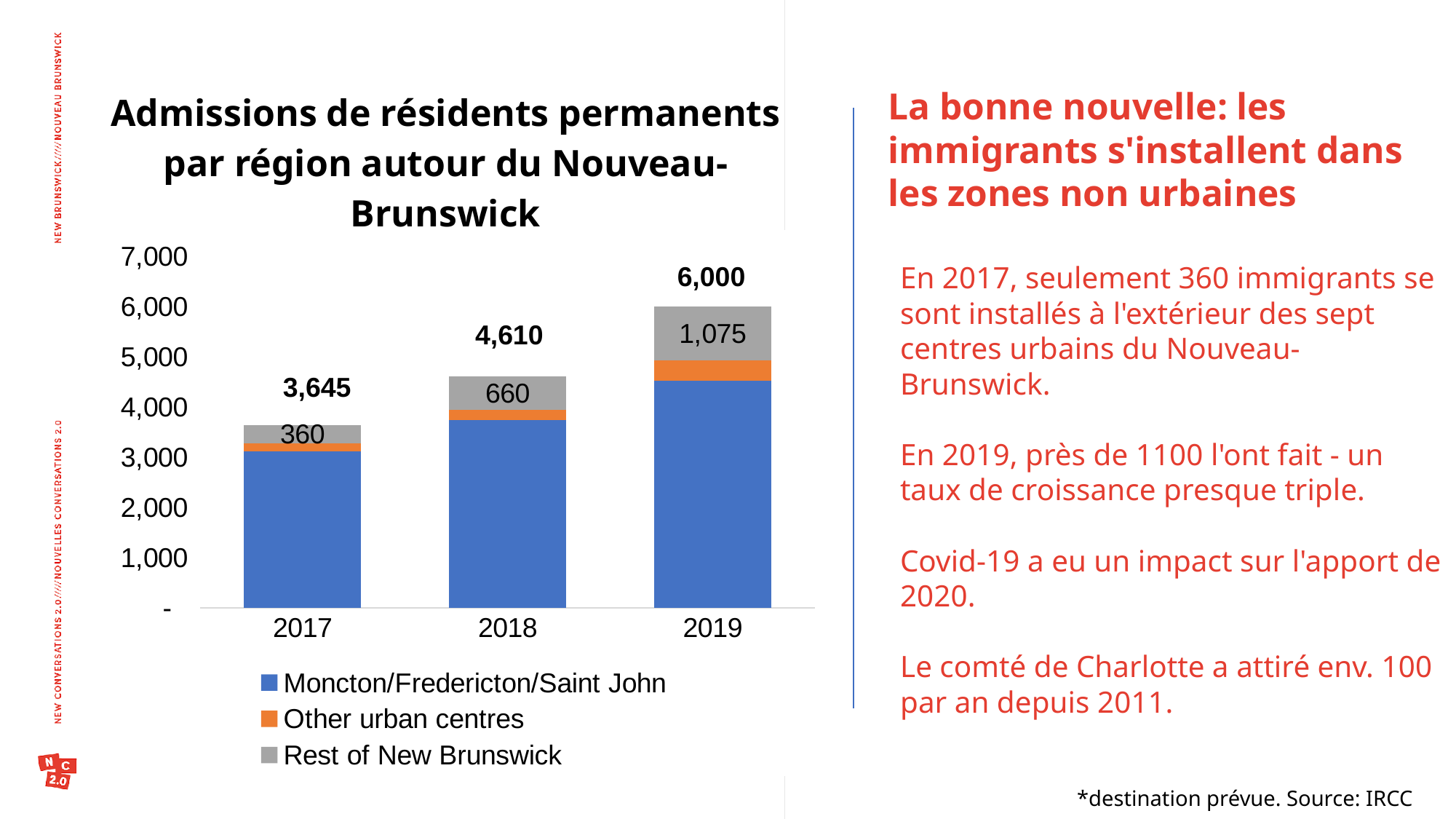
What is the difference between the Rest of New Brunswick values for 2019 and 2017? 715 Is the value for Moncton/Fredericton/Saint John in 2019 greater or less than 4,000? greater Which year has the lowest value for Rest of New Brunswick? 2017 What is the value for Rest of New Brunswick in 2018? 660 How many series does the legend list? 3 What is the total value of the stacked bar for 2019? 6,000 Which year has the highest total admissions? 2019 What kind of chart is shown on the slide? Stacked bar chart What is the difference between the total for 2019 and the total for 2017? 2,355 Do the total admissions rise or fall from 2017 to 2019? Rise What is the value for Rest of New Brunswick in 2019? 1,075 What is the total value of the stacked bar for 2017? 3,645